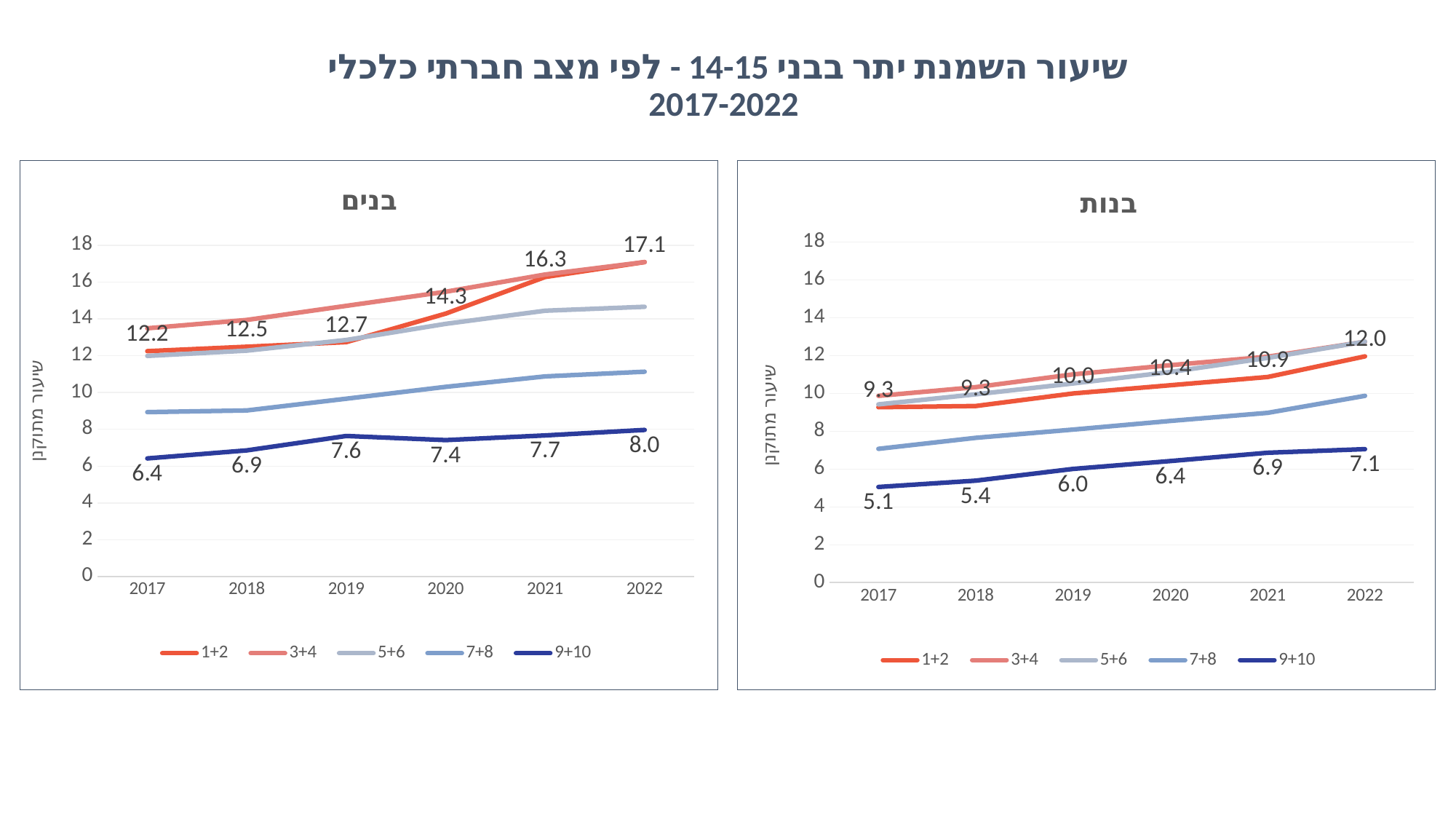
In the left chart (בנים), what is the value for series 9+10 in 2017? 6.4 In the right chart (בנות), what is the value for series 9+10 in 2022? 7.1 How many series does the legend of the left chart (בנים) list? 5 In the right chart (בנות), what is the difference between the 1+2 value and the 9+10 value in 2022? 4.9 In the right chart (בנות), what is the value for series 1+2 in 2021? 10.9 What kind of chart is the right chart (בנות)? line chart In the left chart (בנים), what is the difference between the 1+2 value in 2022 and the 1+2 value in 2017? 4.9 In the left chart (בנים), what is the value for series 1+2 in 2022? 17.1 In the left chart (בנים), which is larger: the 9+10 value in 2019 or in 2020? 2019 In the right chart (בנות), is the value for series 7+8 in 2022 greater or less than 8? greater In the left chart (בנים), in which year is the value for series 1+2 highest? 2022 In the right chart (בנות), in which year is the value for series 9+10 lowest? 2017